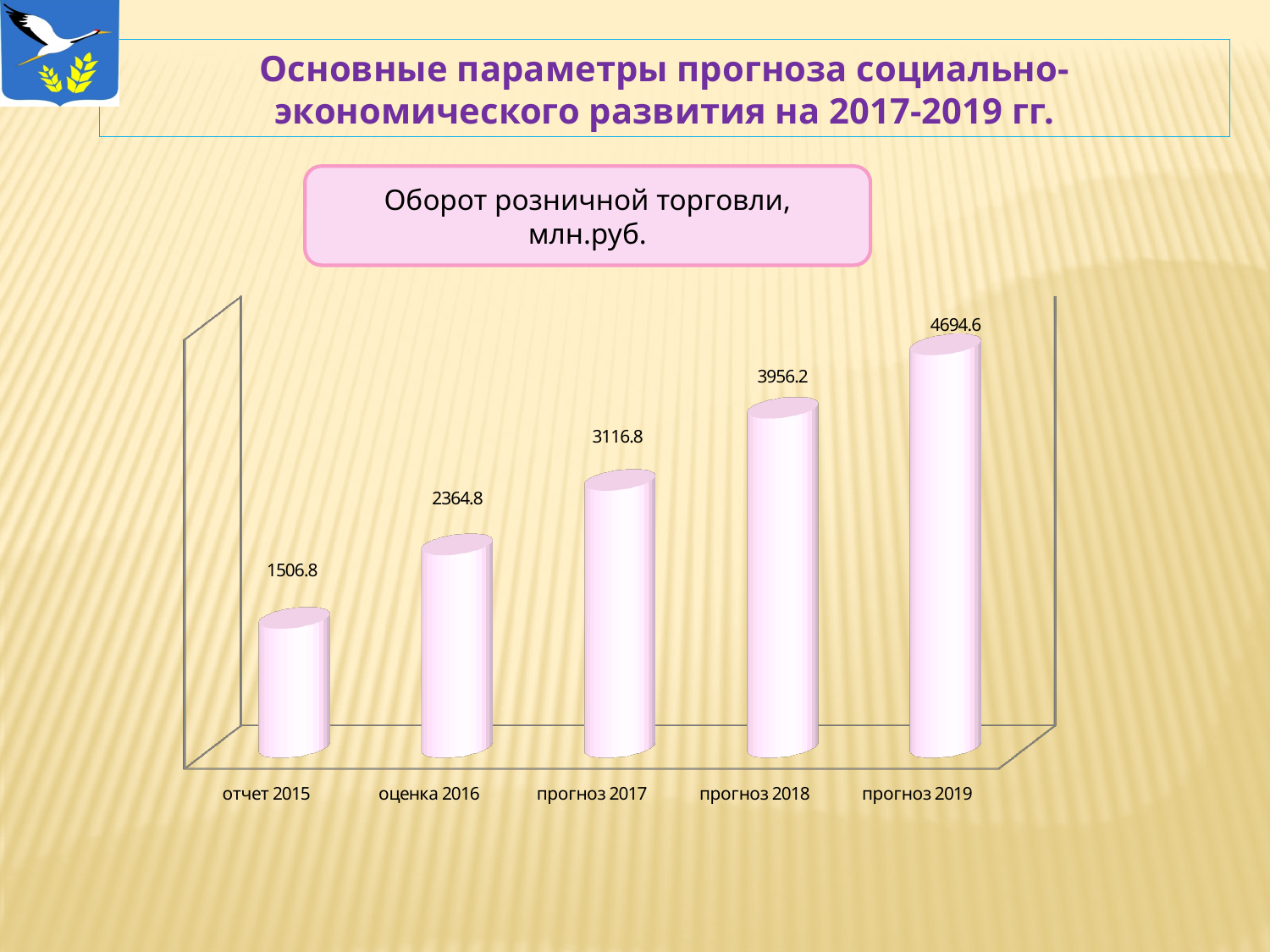
Which is larger, the value for оценка 2016 or the value for прогноз 2018? прогноз 2018 What is the value for прогноз 2017? 3116.8 Which category has the lowest value? отчет 2015 What kind of chart is shown on the slide? bar chart What is the value for прогноз 2019? 4694.6 What is the difference between the values for прогноз 2019 and отчет 2015? 3187.8 Which category has the highest value? прогноз 2019 What is the value for оценка 2016? 2364.8 How many categories are shown on the chart? 5 What is the difference between the values for прогноз 2018 and прогноз 2017? 839.4 Do the values rise or fall from отчет 2015 to прогноз 2019? rise What is the value for отчет 2015? 1506.8